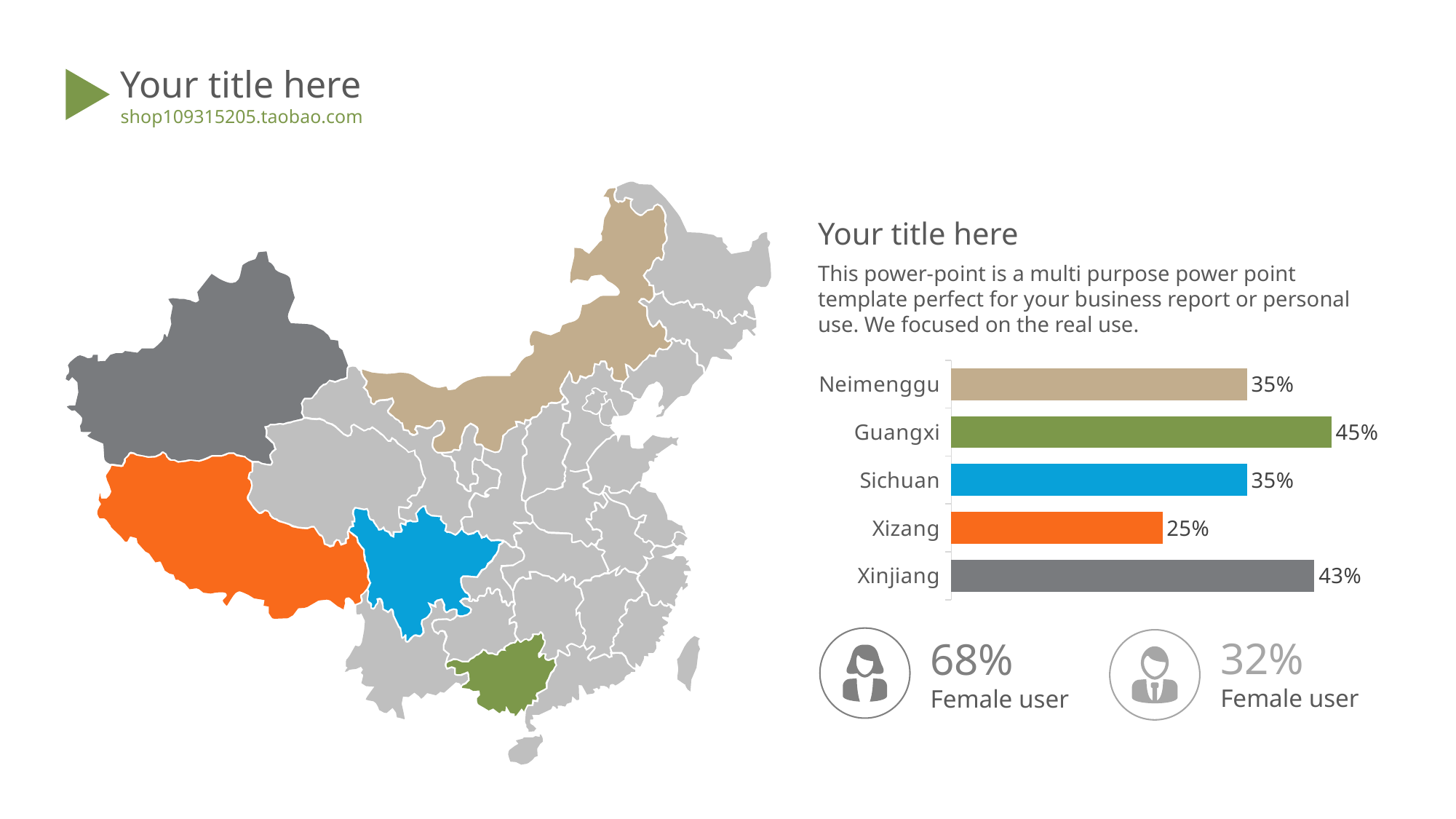
What kind of chart is shown on the slide? bar chart What is the value for Xizang in the bar chart? 25% What is the value for Xinjiang in the bar chart? 43% What is the difference between the values for Xinjiang and Sichuan? 8% Which category has the lowest value in the bar chart? Xizang How many categories are shown in the bar chart? 5 What is the value for Neimenggu in the bar chart? 35% What is the value for Guangxi in the bar chart? 45% Which is larger, the value for Xinjiang or the value for Neimenggu? Xinjiang What colour is the bar for Sichuan? blue Which category has the highest value in the bar chart? Guangxi What is the difference between the values for Guangxi and Xizang? 20%